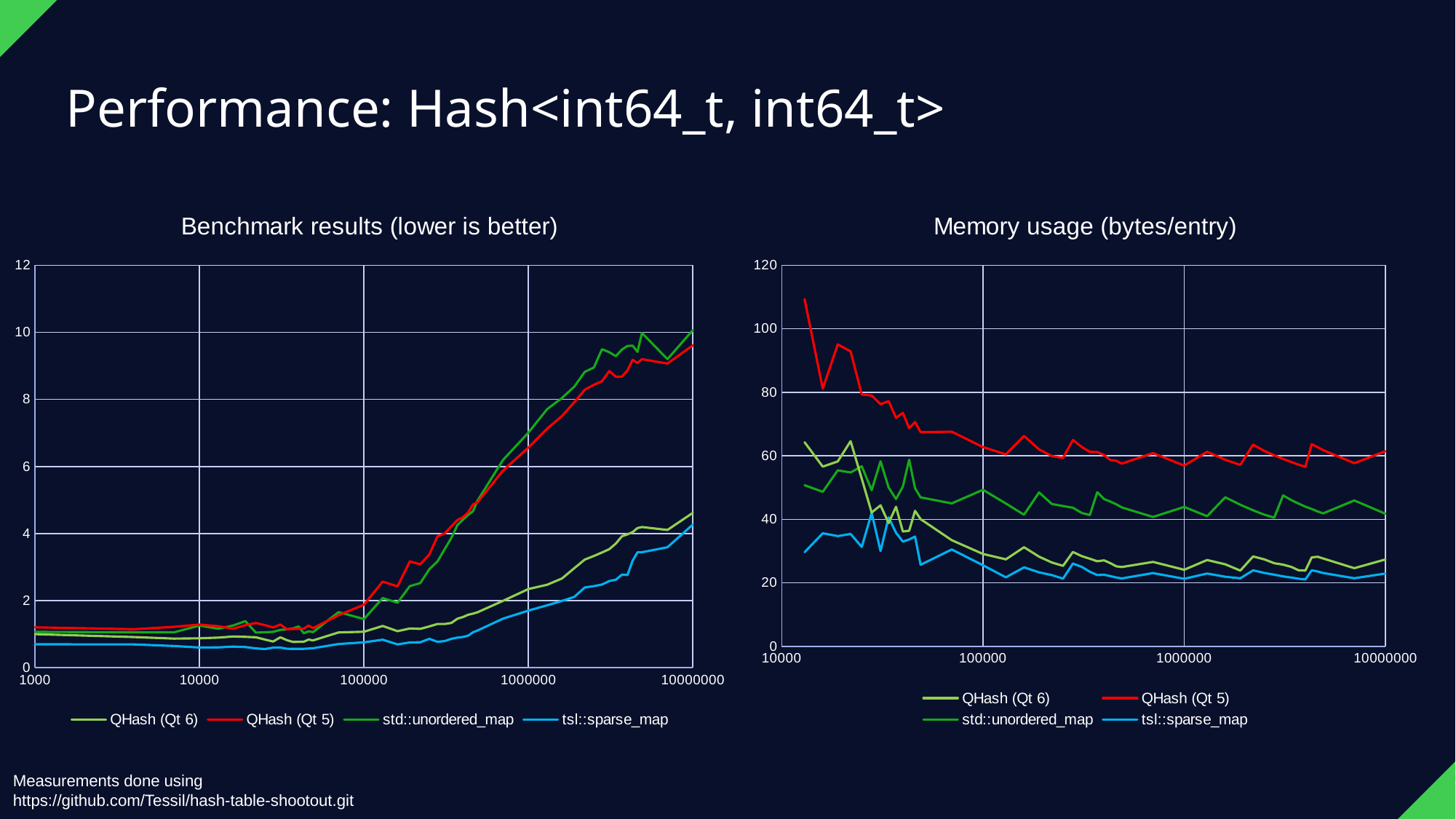
In the 'Memory usage (bytes/entry)' chart, is the value for QHash (Qt 5) at 10000000 greater or less than 40? greater In the 'Benchmark results (lower is better)' chart, which is larger at 1000000: QHash (Qt 5) or QHash (Qt 6)? QHash (Qt 5) In the 'Memory usage (bytes/entry)' chart, is the value for tsl::sparse_map at 10000000 greater or less than 40? less In the 'Memory usage (bytes/entry)' chart, which series has the lowest values at 10000000? tsl::sparse_map In the 'Memory usage (bytes/entry)' chart, which series has the highest values across the x axis? QHash (Qt 5) In the 'Benchmark results (lower is better)' chart, is the value for tsl::sparse_map at 10000000 greater or less than 6? less What kind of chart is the 'Benchmark results (lower is better)' chart? line chart In the 'Benchmark results (lower is better)' chart, do the values for QHash (Qt 5) rise or fall as the x axis increases? rise In the 'Memory usage (bytes/entry)' chart, do the values for QHash (Qt 5) rise or fall as the x axis increases? fall What is the title of the chart on the right of the slide? Memory usage (bytes/entry) How many series does the legend of the 'Memory usage (bytes/entry)' chart list? 4